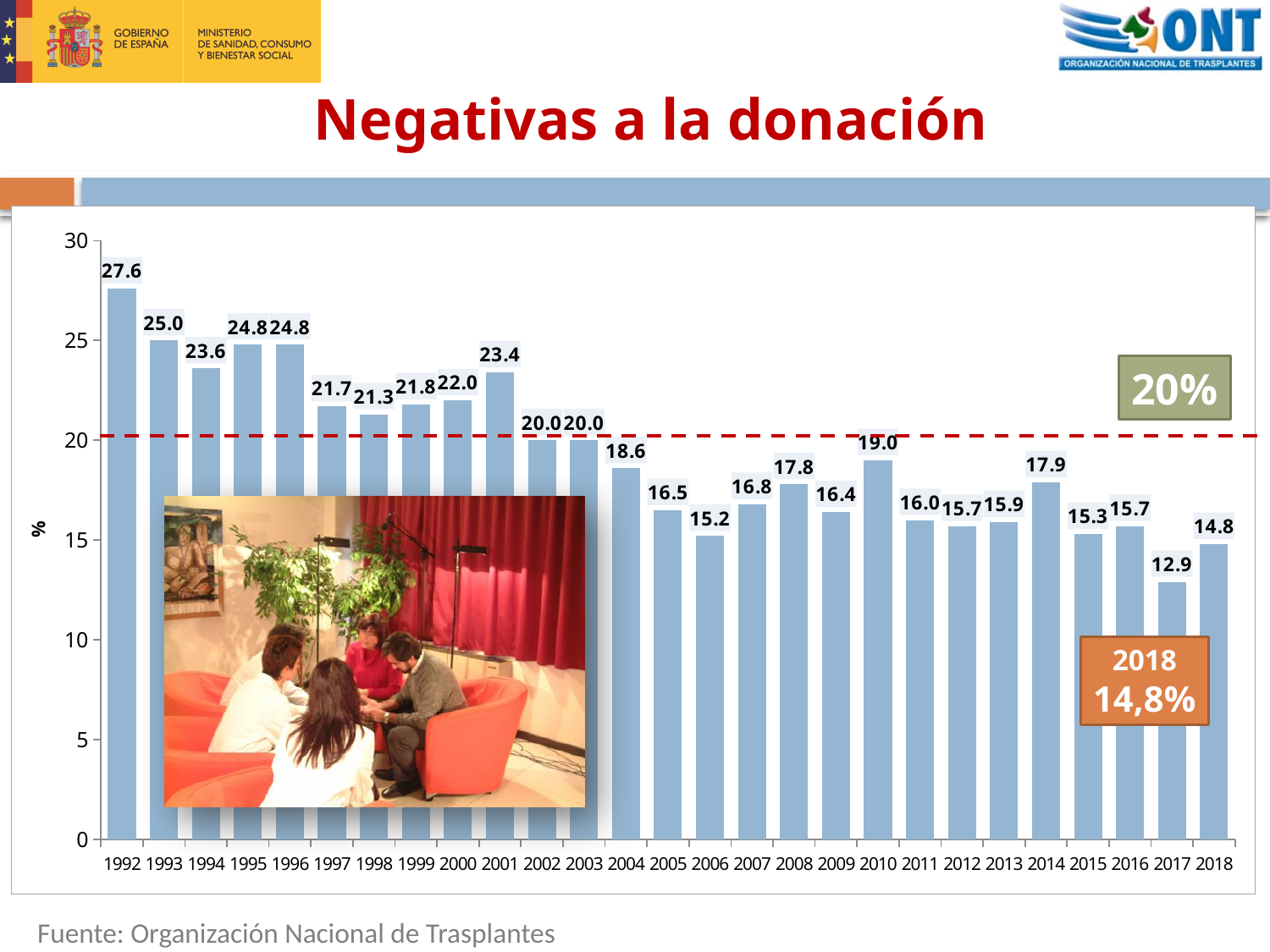
How many years are shown on the x axis? 27 What is the difference between the values for 2017 and 2018? 1.9 What kind of chart is shown on the slide? bar chart What is the value for 1992? 27.6 Which year has the highest value? 1992 What is the title of the slide? Negativas a la donación Which is larger, the value for 2001 or the value for 2004? 2001 What is the difference between the values for 1992 and 2018? 12.8 What is the value for 2010? 19.0 What is the value for 2018? 14.8 Which year has the lowest value? 2017 Is the value for 2005 greater or less than 20? less